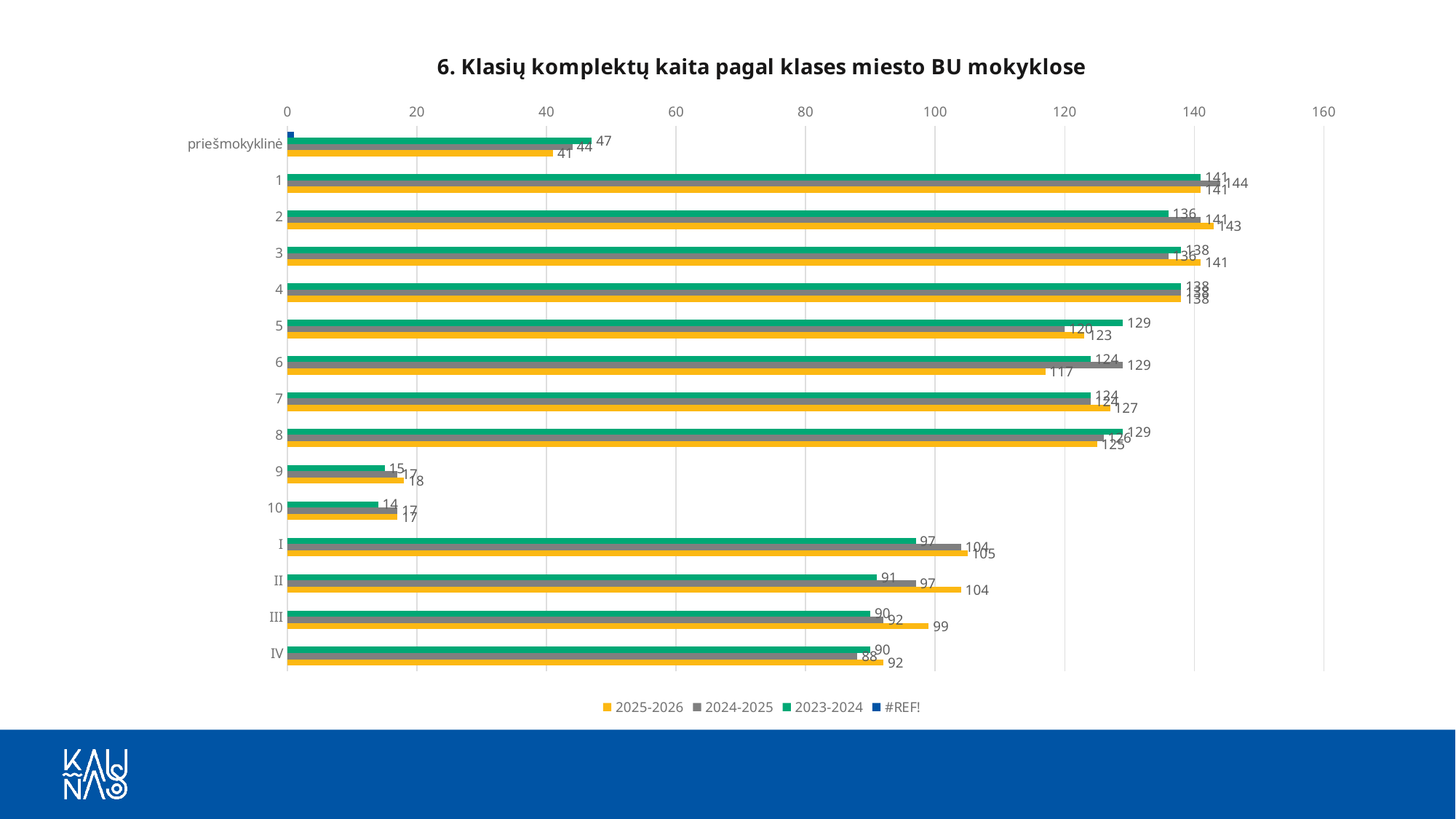
In the 2025-2026 series, which is larger: class III or class IV? III Is the 2025-2026 value for class I greater or less than 100? greater Which category has the highest 2025-2026 value? 2 How many categories are shown on the vertical axis? 15 How many series does the legend list? 4 What is the 2023-2024 value for priešmokyklinė? 47 What is the 2025-2026 value for class II? 104 What is the 2023-2024 value for class 5? 129 For class 6, what is the difference between the 2023-2024 value and the 2025-2026 value? 7 What is the 2024-2025 value for class I? 104 What kind of chart is shown on the slide? bar chart Which category has the lowest 2023-2024 value? 10